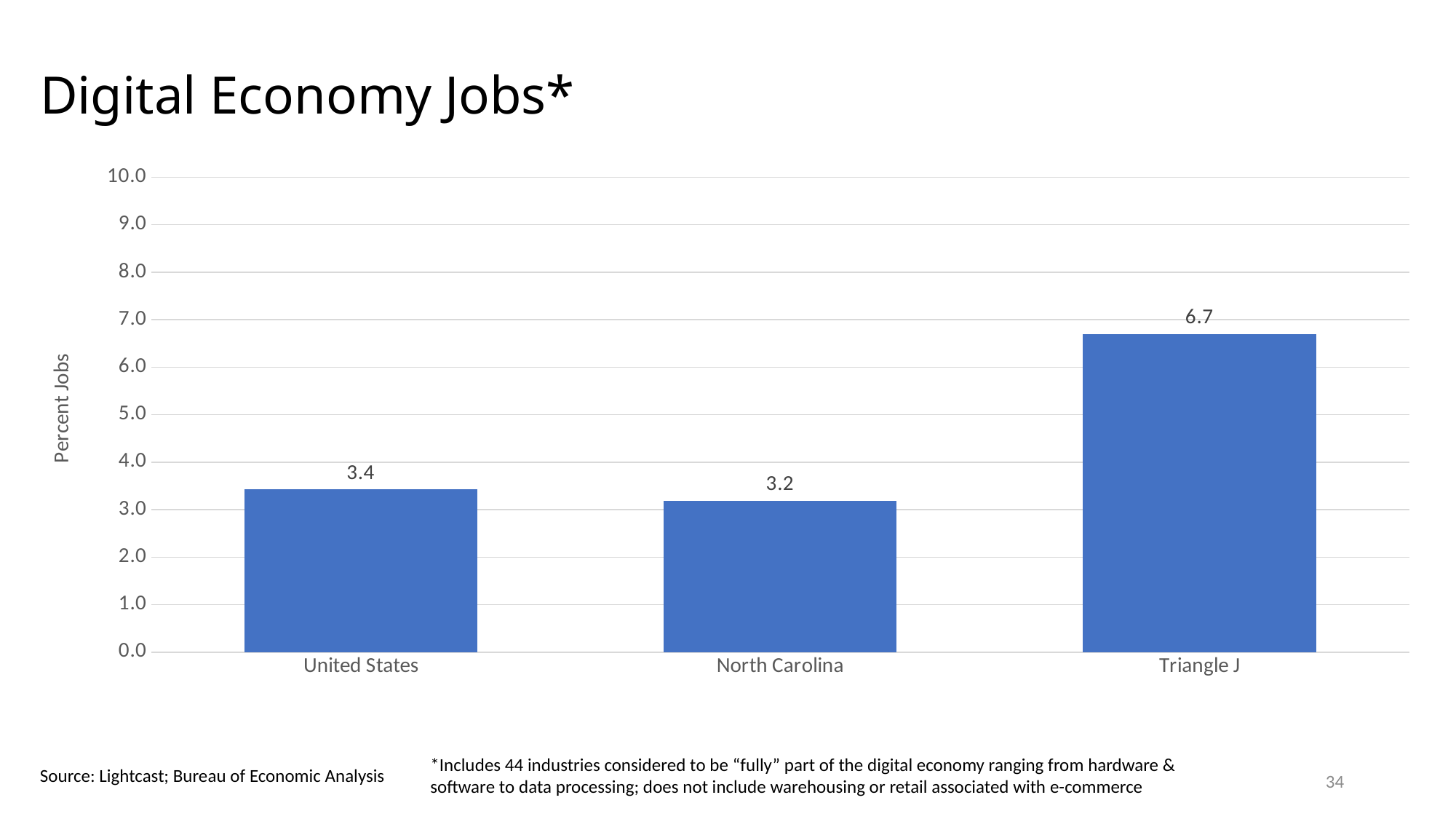
What is the value for Triangle J? 6.7 Which is larger, the value for Triangle J or the value for North Carolina? Triangle J What is the value for North Carolina? 3.2 What is the difference between the values for United States and North Carolina? 0.2 What kind of chart is shown on the slide? bar chart Is the value for Triangle J greater or less than 6.0? greater How many categories are shown on the x axis? 3 What is the difference between the values for Triangle J and United States? 3.3 Which category has the highest value? Triangle J What is the label of the vertical axis? Percent Jobs Which category has the lowest value? North Carolina What is the value for United States? 3.4